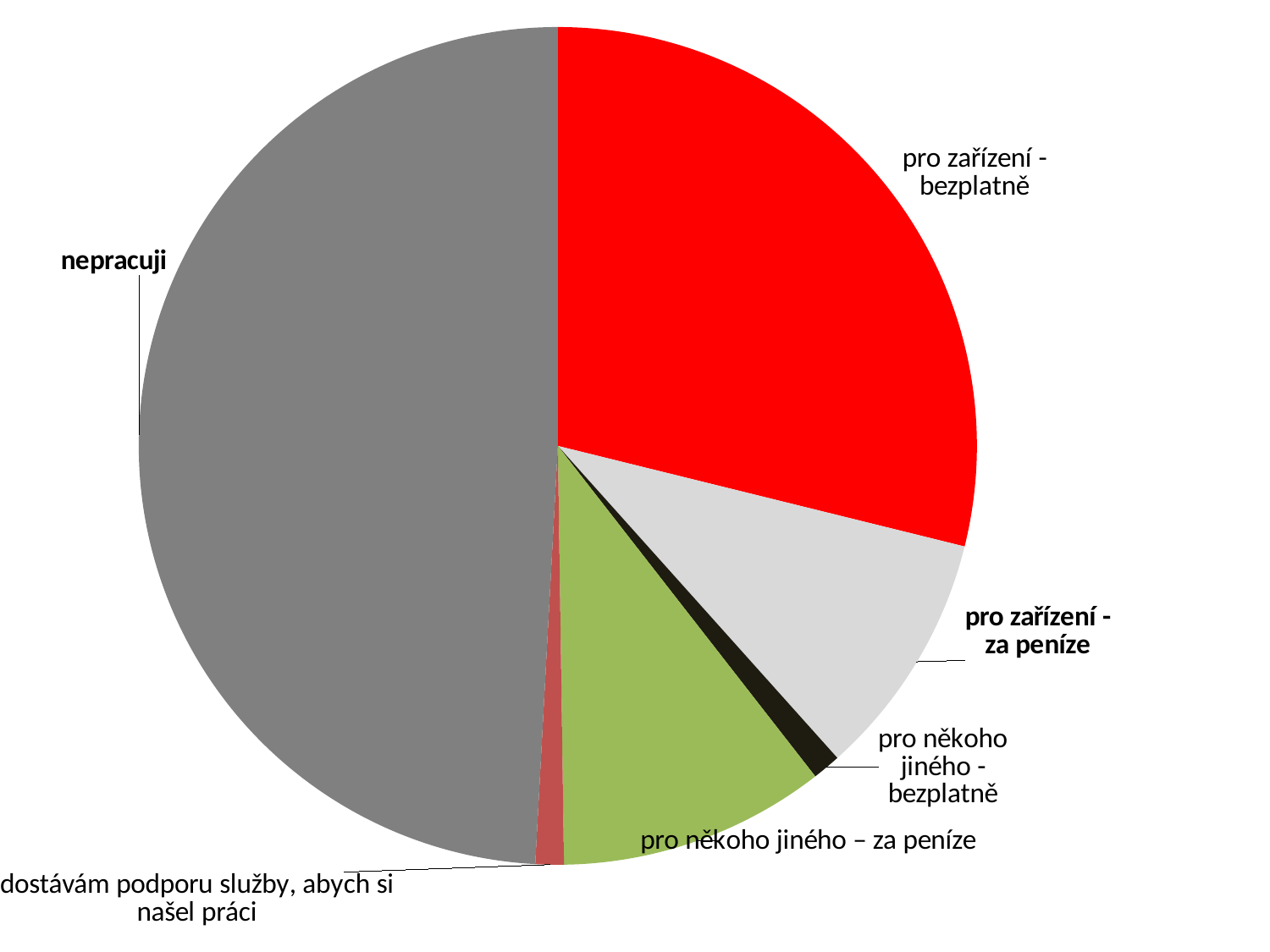
What colour is the "pro zařízení - bezplatně" slice? red Which slice is larger: "pro zařízení - bezplatně" or "pro někoho jiného – za peníze"? pro zařízení - bezplatně What kind of chart is shown on the slide? pie chart Which slice is larger: "pro někoho jiného – za peníze" or "pro někoho jiného - bezplatně"? pro někoho jiného – za peníze What colour is the "nepracuji" slice? grey Which category has the largest slice of the pie? nepracuji Which slice is larger: "nepracuji" or "pro zařízení - bezplatně"? nepracuji How many slices does the pie chart have? 6